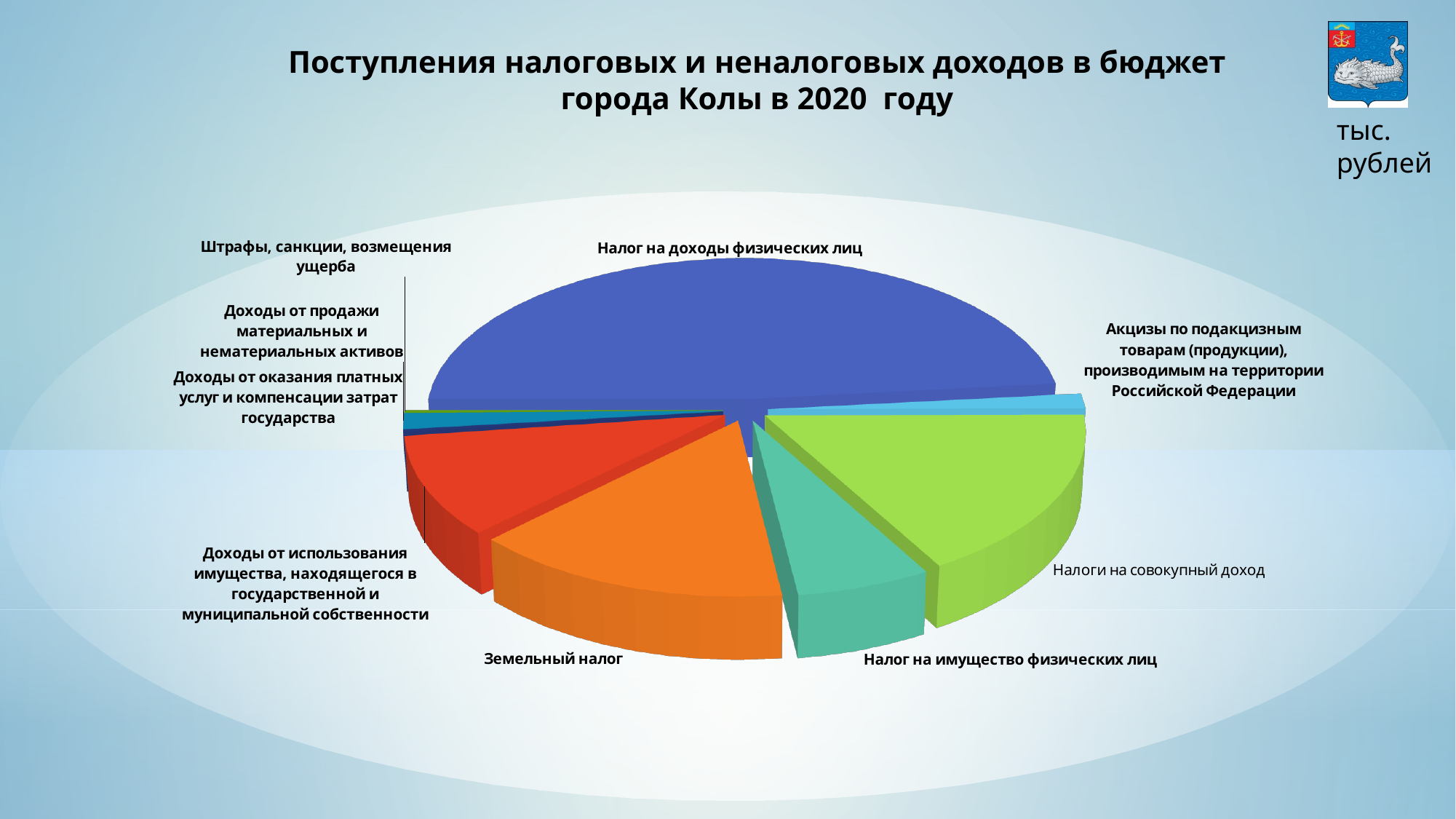
How many categories (slices) does the pie chart have? 9 Which category has the largest slice of the pie chart? Налог на доходы физических лиц What is the title of the chart on the slide? Поступления налоговых и неналоговых доходов в бюджет города Колы в 2020 году Which slice is larger: Налог на доходы физических лиц or Земельный налог? Налог на доходы физических лиц Which slice is larger: Земельный налог or Налог на имущество физических лиц? Земельный налог Which slice is larger: Налоги на совокупный доход or Акцизы по подакцизным товарам (продукции), производимым на территории Российской Федерации? Налоги на совокупный доход What colour is the slice for Земельный налог? orange What kind of chart is shown on the slide? pie chart